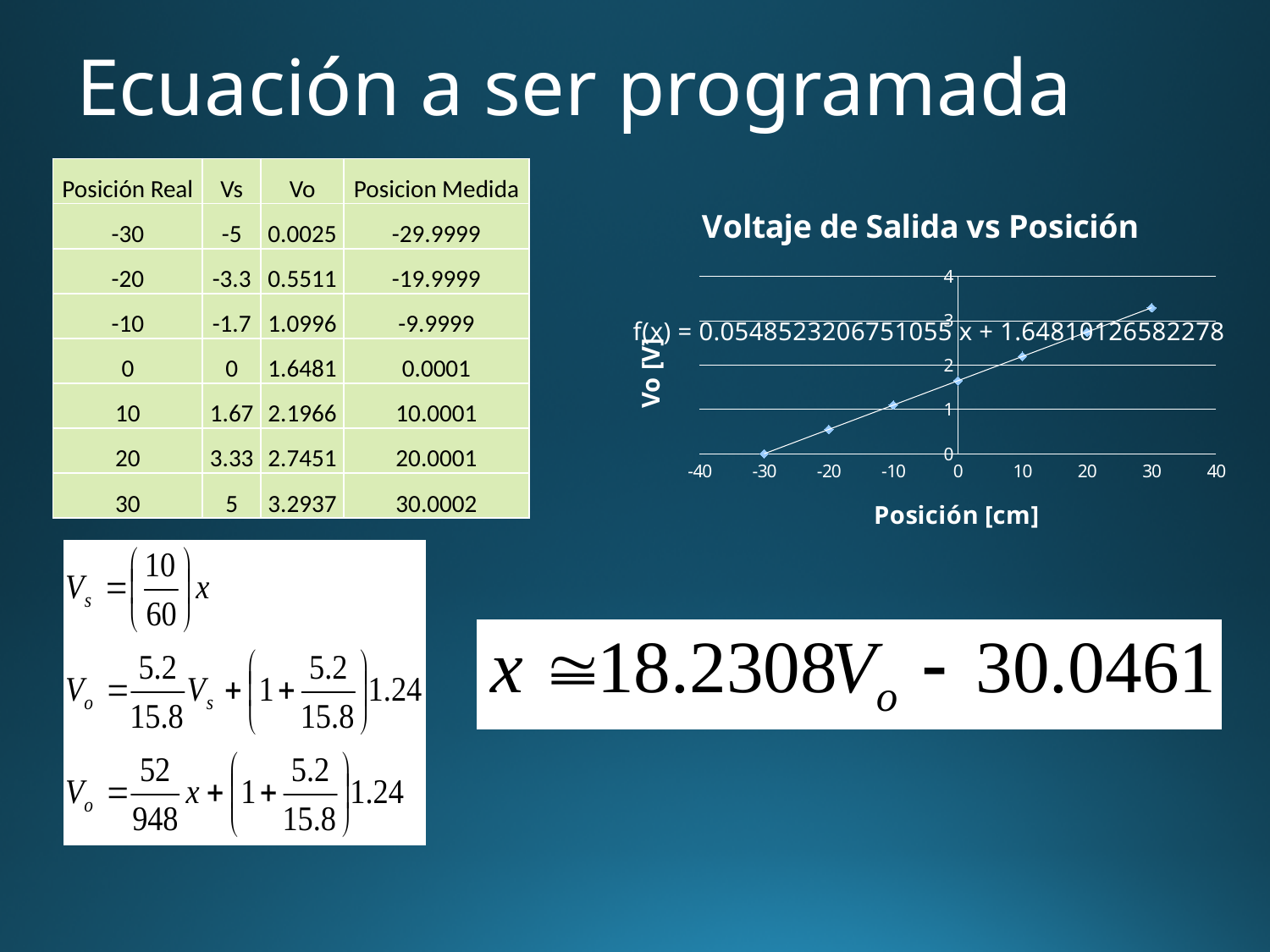
At which position is the plotted output voltage highest? 30 Is the plotted value at position 20 greater or less than 2? greater Is the plotted value at position 30 greater or less than 3? greater Which plotted value is larger, the one at position -20 or the one at position 10? position 10 Is the plotted value at position -30 greater or less than 1? less What kind of chart is shown on the slide? scatter chart What is the title of the chart? Voltaje de Salida vs Posición At which position is the plotted output voltage lowest? -30 Do the plotted values rise or fall as position increases along the x axis? rise How many data points are plotted in the chart? 7 What is the slope shown in the trendline equation on the chart? 0.0548523206751055